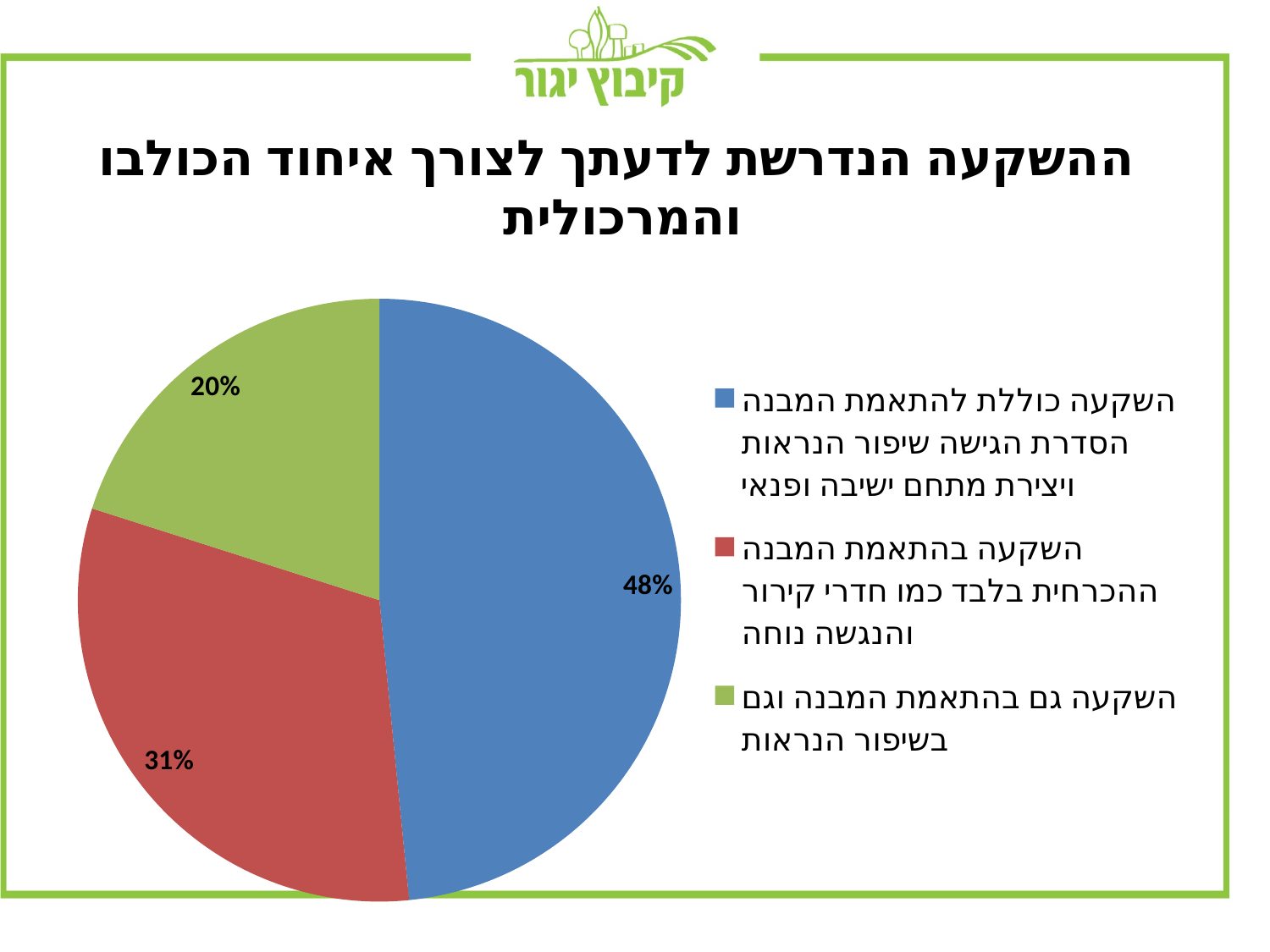
What is the difference in percentage points between the blue slice (48%) and the red slice (31%)? 17 Which slice is larger: the red slice (השקעה בהתאמת המבנה ההכרחית בלבד) or the green slice (השקעה גם בהתאמת המבנה וגם בשיפור הנראות)? The red slice (השקעה בהתאמת המבנה ההכרחית בלבד) How many slices does the pie chart have? 3 What kind of chart is shown on the slide? Pie chart What share of the pie is labelled for the green slice (השקעה גם בהתאמת המבנה וגם בשיפור הנראות)? 20% Which category has the smallest slice of the pie? השקעה גם בהתאמת המבנה וגם בשיפור הנראות Which category has the largest slice of the pie? השקעה כוללת להתאמת המבנה הסדרת הגישה שיפור הנראות ויצירת מתחם ישיבה ופנאי What is the difference in percentage points between the largest slice (48%) and the smallest slice (20%)? 28 What share of the pie is labelled for the red slice (השקעה בהתאמת המבנה ההכרחית בלבד כמו חדרי קירור והנגשה נוחה)? 31% What is the title of the chart on the slide? ההשקעה הנדרשת לדעתך לצורך איחוד הכולבו והמרכולית What share of the pie is labelled for the blue slice (השקעה כוללת להתאמת המבנה הסדרת הגישה שיפור הנראות ויצירת מתחם ישיבה ופנאי)? 48% How many entries does the legend list? 3